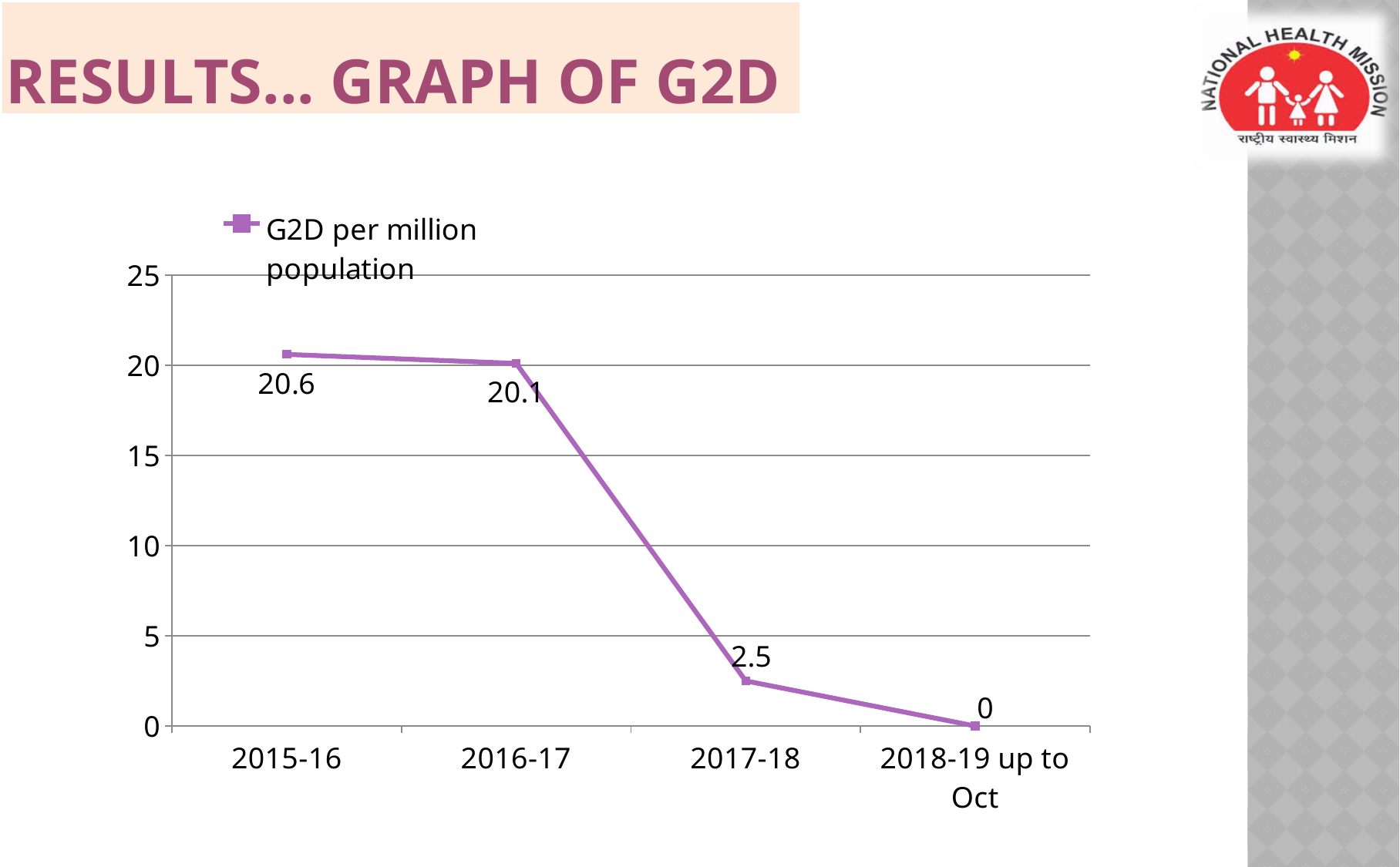
Do the G2D per million population values rise or fall from 2015-16 to 2018-19 up to Oct? fall What is the difference in G2D per million population between 2016-17 and 2017-18? 17.6 What is the G2D per million population value for 2017-18? 2.5 What is the G2D per million population value for 2016-17? 20.1 Which period has the highest G2D per million population? 2015-16 Is the G2D per million population for 2016-17 greater or less than 15? greater How many periods are plotted on the x axis? 4 Which is larger, the G2D per million population for 2015-16 or for 2017-18? 2015-16 Which period has the lowest G2D per million population? 2018-19 up to Oct What is the G2D per million population value for 2018-19 up to Oct? 0 What is the G2D per million population value for 2015-16? 20.6 What kind of chart is shown on the slide? line chart